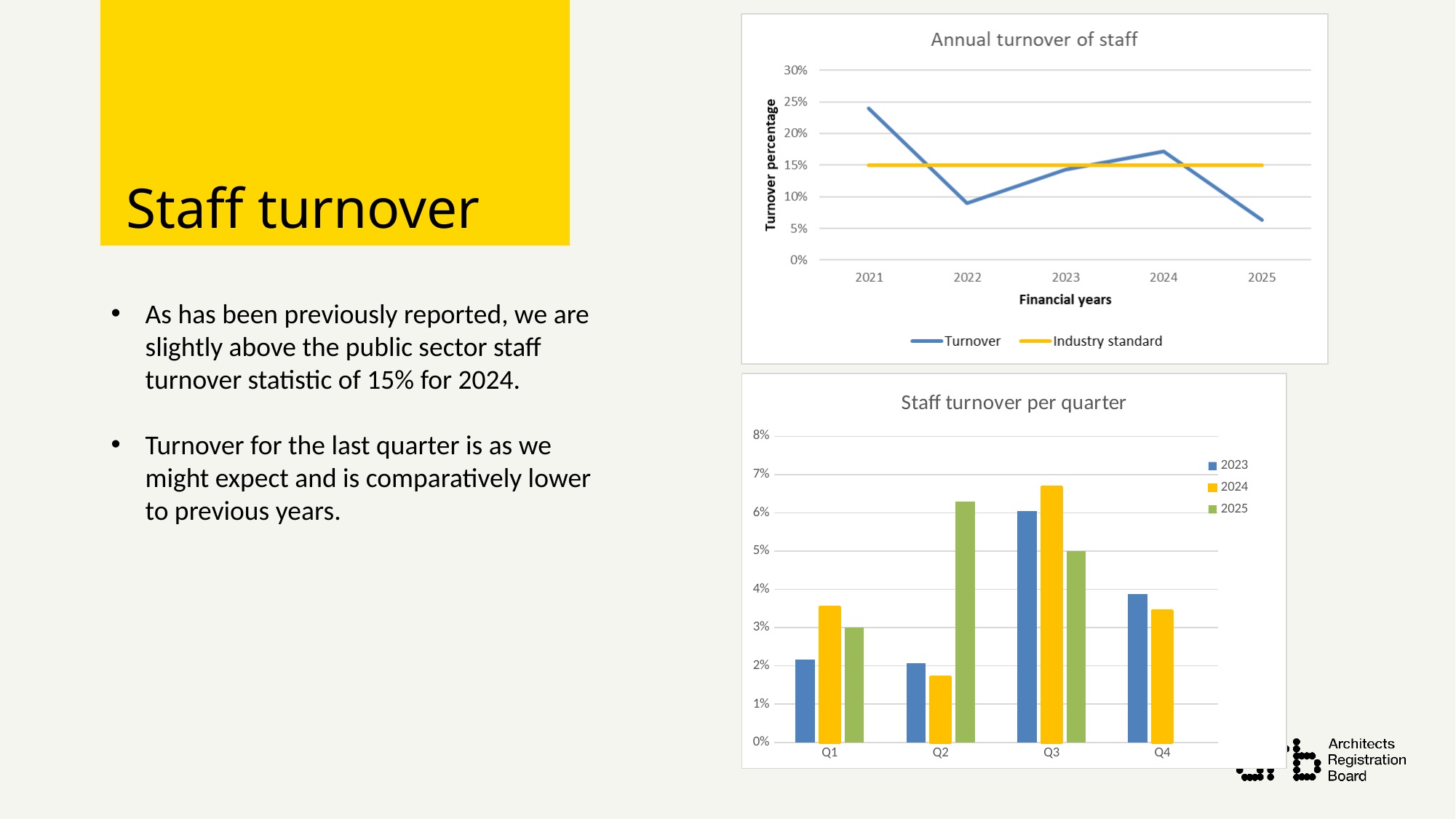
In the 'Annual turnover of staff' chart, how many series does the legend list? 2 In the 'Annual turnover of staff' chart, is the Turnover for 2021 greater or less than 20%? greater What kind of chart is the 'Annual turnover of staff' chart? line chart In the 'Staff turnover per quarter' chart, which is larger for Q3: 2023 or 2024? 2024 In the 'Annual turnover of staff' chart, what is the Industry standard value? 15% In the 'Annual turnover of staff' chart, how many financial years are shown on the x axis? 5 In the 'Staff turnover per quarter' chart, is the value for 2024 in Q2 greater or less than 2%? less What kind of chart is the 'Staff turnover per quarter' chart? bar chart In the 'Staff turnover per quarter' chart, how many series does the legend list? 3 In the 'Annual turnover of staff' chart, which financial year has the lowest Turnover? 2025 In the 'Staff turnover per quarter' chart, which quarter has the highest value for 2025? Q2 In the 'Annual turnover of staff' chart, which financial year has the highest Turnover? 2021